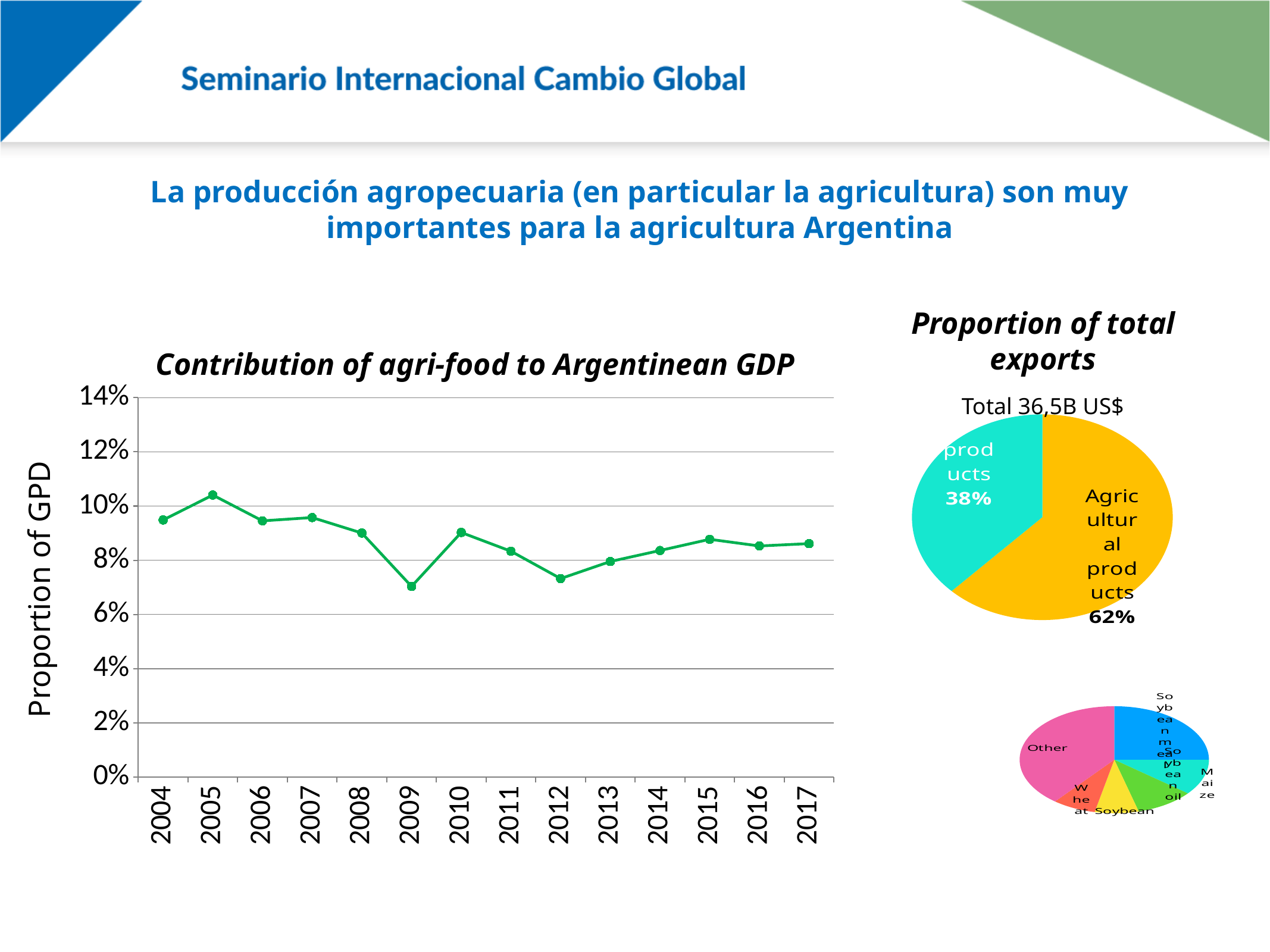
In the 'Proportion of total exports' pie chart, what is the difference in percentage points between Agricultural products and the other products slice? 24 percentage points What is the y-axis label of the 'Contribution of agri-food to Argentinean GDP' chart? Proportion of GPD What total value is printed above the 'Proportion of total exports' pie chart? Total 36,5B US$ In the 'Contribution of agri-food to Argentinean GDP' chart, is the value for 2005 greater or less than 10%? greater How many years are plotted in the 'Contribution of agri-food to Argentinean GDP' chart? 14 In the 'Proportion of total exports' pie chart, what share do Agricultural products have? 62% In the 'Contribution of agri-food to Argentinean GDP' chart, is the value for 2009 greater or less than 8%? less What type of chart is 'Contribution of agri-food to Argentinean GDP'? line chart In the 'Contribution of agri-food to Argentinean GDP' chart, is the value for 2004 greater or less than 8%? greater In the 'Contribution of agri-food to Argentinean GDP' chart, which year has the lowest value? 2009 In the 'Contribution of agri-food to Argentinean GDP' chart, which is larger, the value for 2005 or the value for 2012? 2005 In the 'Contribution of agri-food to Argentinean GDP' chart, which year has the highest value? 2005